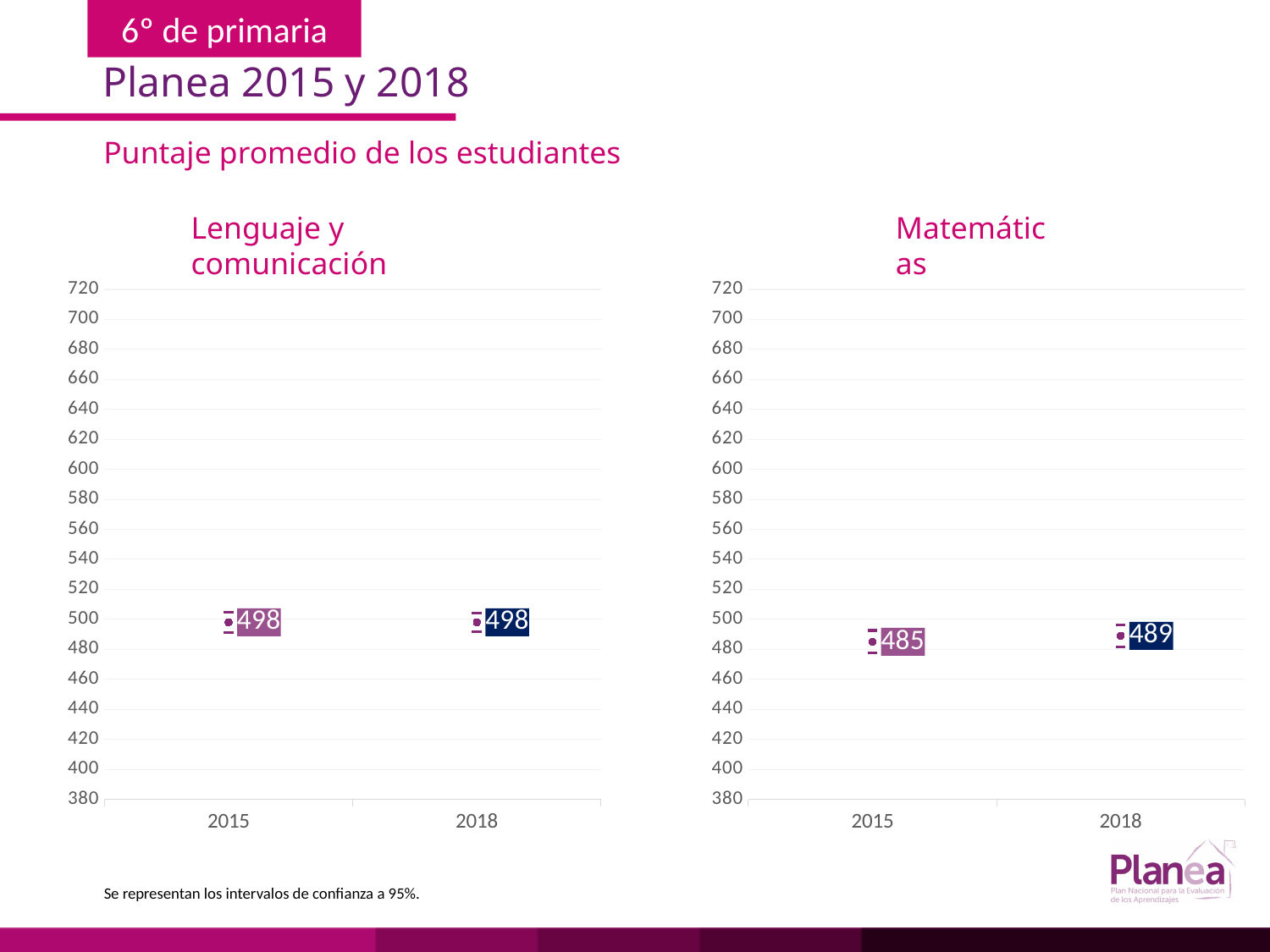
In the 'Lenguaje y comunicación' chart, what is the difference between the 2015 and 2018 values? 0 In the 'Matemáticas' chart, which year has the lower value? 2015 In the 'Matemáticas' chart, what is the value for 2018? 489 What is the lowest value shown on the y axis of the 'Matemáticas' chart? 380 In the 'Matemáticas' chart, do the values rise or fall from 2015 to 2018? rise How many years are plotted on the x axis of the 'Lenguaje y comunicación' chart? 2 In the 'Lenguaje y comunicación' chart, what is the value for 2018? 498 In the 'Matemáticas' chart, is the value for 2015 greater or less than 500? less In the 'Lenguaje y comunicación' chart, what is the value for 2015? 498 In the 'Matemáticas' chart, which year has the higher value? 2018 In the 'Matemáticas' chart, what is the difference between the 2018 and 2015 values? 4 In the 'Matemáticas' chart, what is the value for 2015? 485